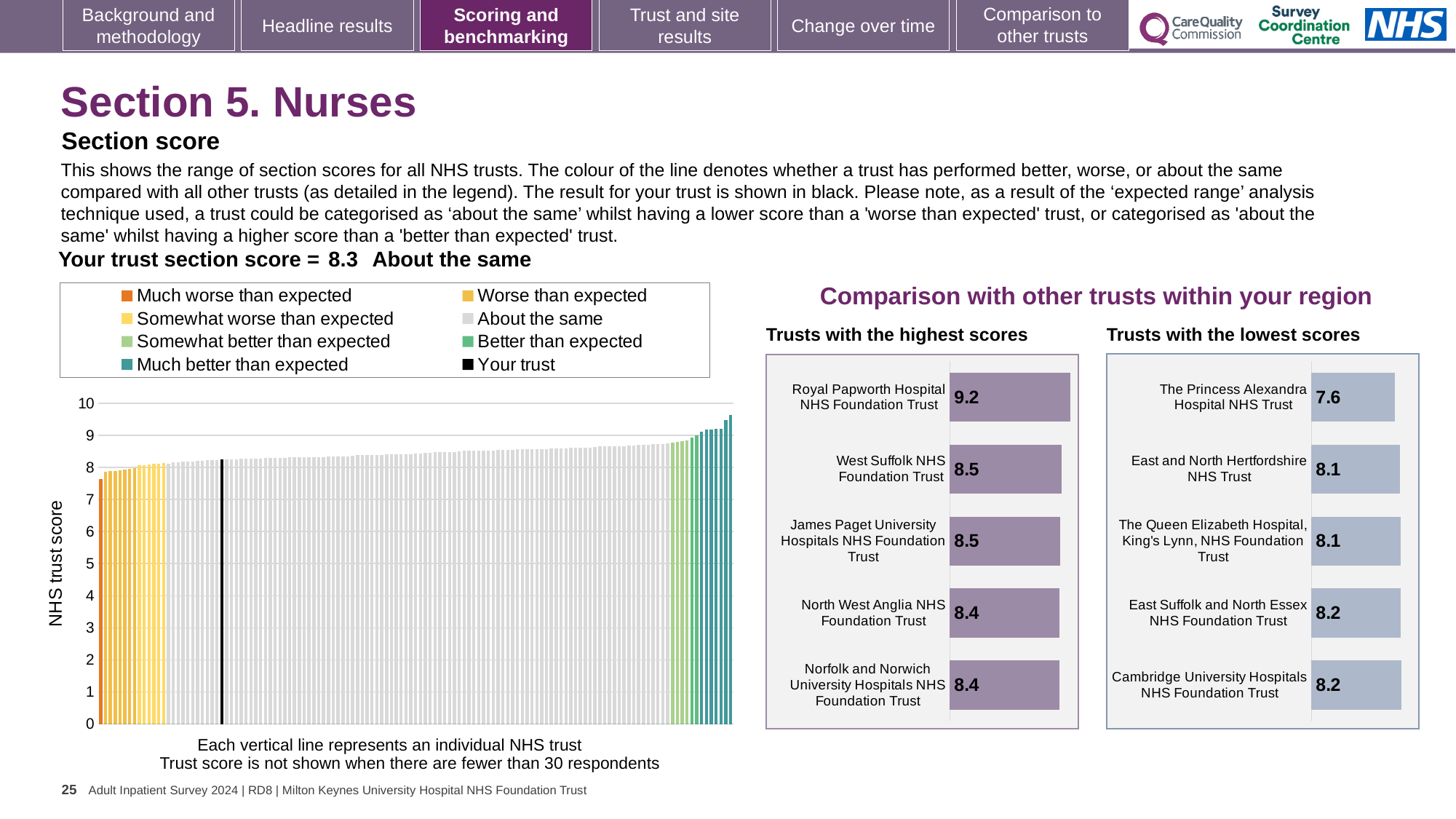
In the main NHS trust score chart, do the values rise or fall from left to right along the x axis? Rise In the 'Trusts with the lowest scores' chart, which trust has the lowest score? The Princess Alexandra Hospital NHS Trust What is your trust's section score for Nurses shown on the slide? 8.3 In the 'Trusts with the lowest scores' chart, what is the score for The Princess Alexandra Hospital NHS Trust? 7.6 How many trusts are shown in the 'Trusts with the highest scores' chart? 5 In the 'Trusts with the lowest scores' chart, which has the larger score: Cambridge University Hospitals NHS Foundation Trust or East and North Hertfordshire NHS Trust? Cambridge University Hospitals NHS Foundation Trust In the 'Trusts with the highest scores' chart, what is the difference between the scores of Royal Papworth Hospital NHS Foundation Trust and North West Anglia NHS Foundation Trust? 0.8 In the 'Trusts with the highest scores' chart, what is the score for Royal Papworth Hospital NHS Foundation Trust? 9.2 In the 'Trusts with the highest scores' chart, which trust has the highest score? Royal Papworth Hospital NHS Foundation Trust In the 'Trusts with the lowest scores' chart, what is the score for East Suffolk and North Essex NHS Foundation Trust? 8.2 What kind of chart is the main NHS trust score chart on the left of the slide? Bar chart How many entries does the legend of the main NHS trust score chart list? 8